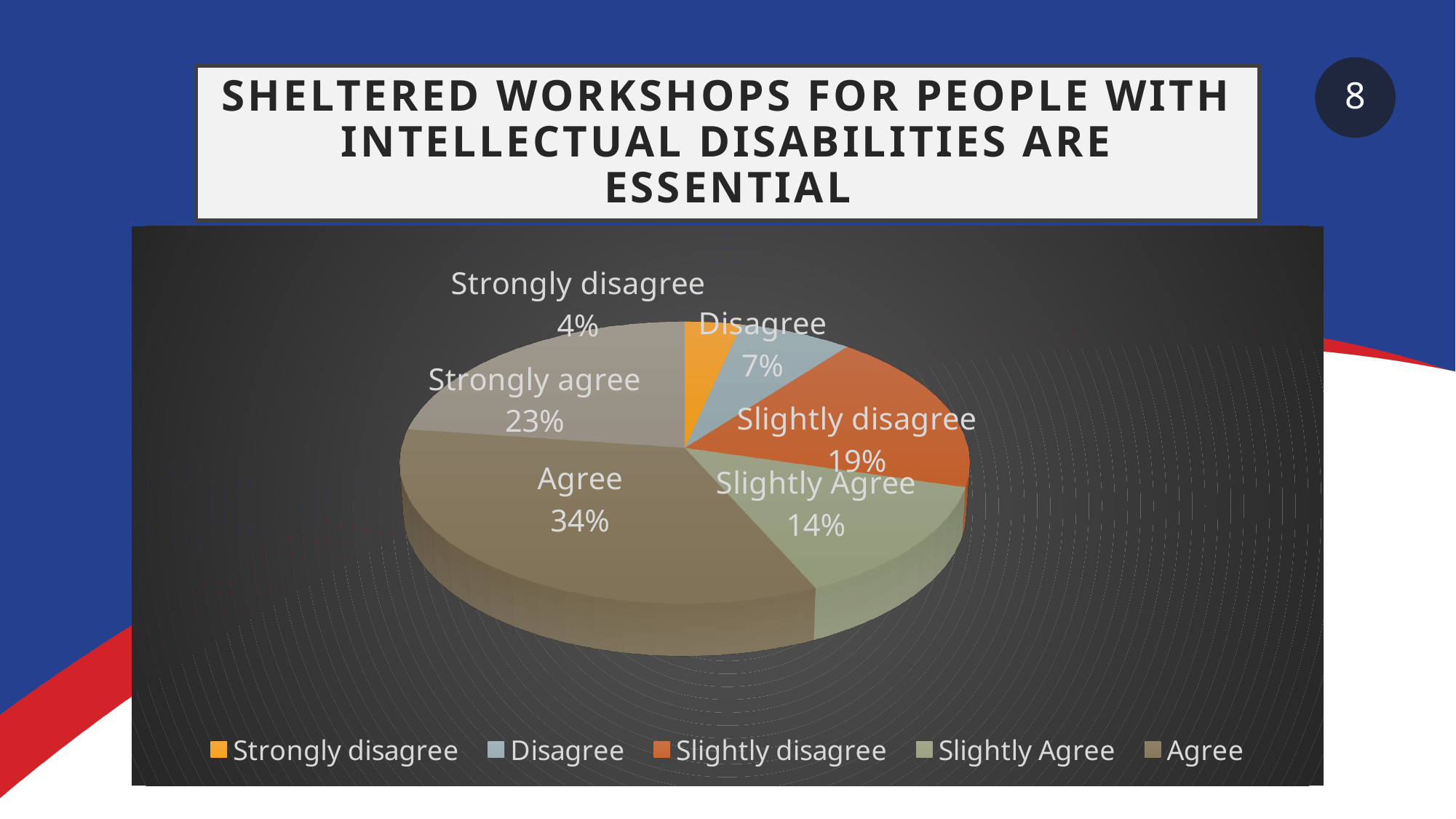
What type of chart is shown on the slide? Pie chart What percentage of respondents chose "Agree"? 34% Which response category has the largest share of the pie? Agree What percentage of respondents chose "Strongly disagree"? 4% What is the title of the slide containing the pie chart? Sheltered workshops for people with intellectual disabilities are essential What percentage of respondents chose "Slightly disagree"? 19% What is the difference in percentage points between "Agree" and "Strongly agree"? 11 Which response category has the smallest share of the pie? Strongly disagree Which is larger, the share for "Slightly disagree" or the share for "Slightly Agree"? Slightly disagree How many slices does the pie chart have? 6 What is the combined percentage of "Disagree" and "Strongly disagree"? 11% What percentage of respondents chose "Strongly agree"? 23%